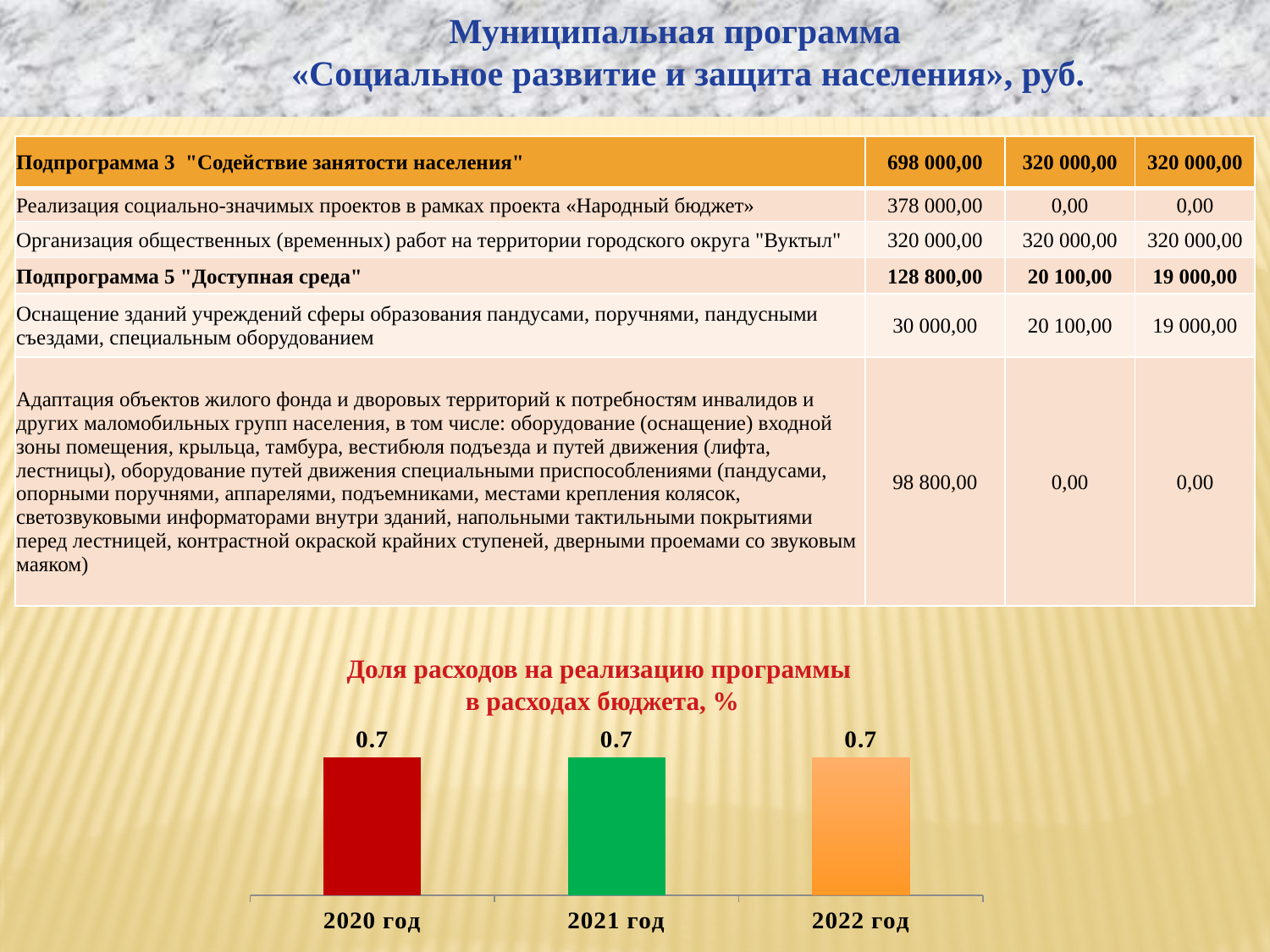
How many bars (categories) are shown in the chart? 3 Which year is the first category on the x axis of the chart? 2020 год Do the values rise, fall or stay the same from 2020 год to 2022 год? Stay the same What is the value for 2021 год in the chart? 0.7 What is the value for 2020 год in the chart? 0.7 What is the difference between the values for 2021 год and 2020 год? 0 What is the value for 2022 год in the chart? 0.7 Which year is the last category on the x axis of the chart? 2022 год What is the title of the chart? Доля расходов на реализацию программы в расходах бюджета, % What colour is the bar for 2021 год? Green What kind of chart is shown on the slide? Bar chart What is the difference between the values for 2020 год and 2022 год? 0